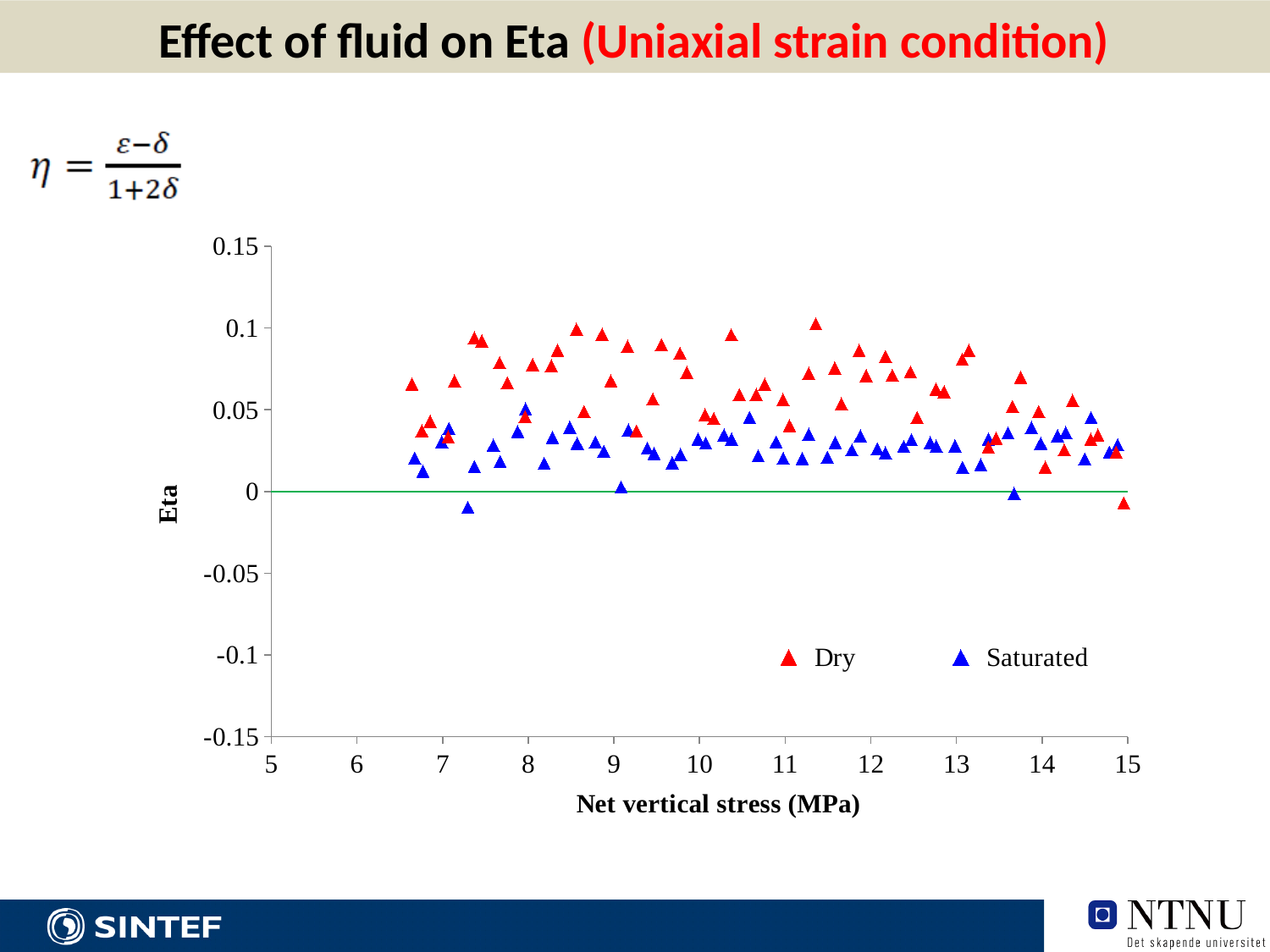
Are all Saturated values greater or less than 0.1? less What are the two series named in the chart legend? Dry and Saturated Which series is plotted with red triangles? Dry Which series generally has higher Eta values, Dry or Saturated? Dry Is the lowest Saturated value greater or less than 0? less How many series does the chart legend list? 2 What kind of chart is shown on the slide? Scatter chart Is the highest Dry value greater or less than 0.05? greater What is the title of the x axis of the chart? Net vertical stress (MPa)